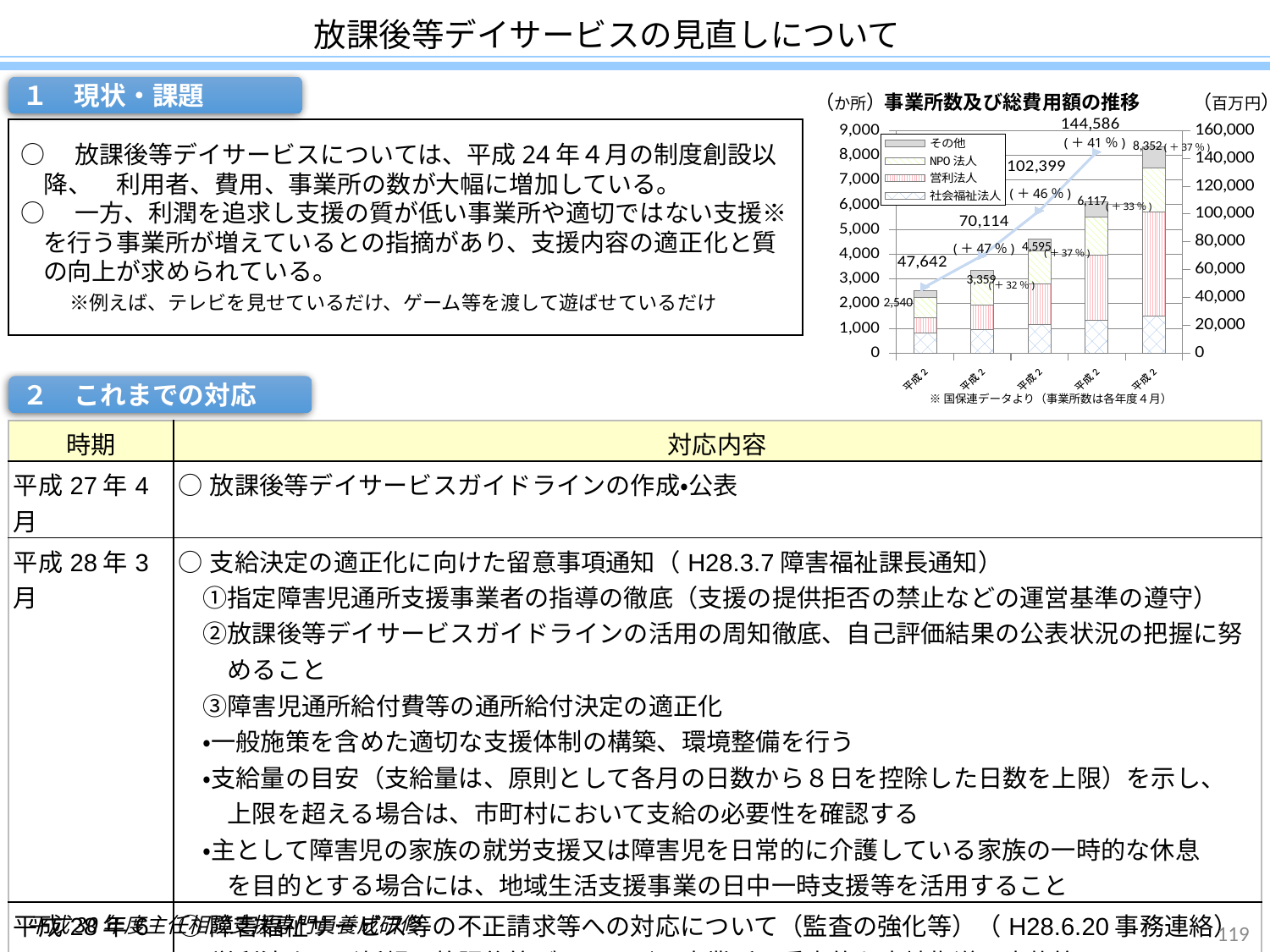
What is the lowest value labelled on the line in the chart? 47,642 Which bar has the highest total value? the rightmost (last) bar, 8,352 Do the bar totals rise or fall from left to right along the x axis? rise How many bars are plotted in the chart? 5 What is the difference between the total of the last bar (8,352) and the total of the first bar (2,540)? 5,812 How many series does the chart's legend list? 4 Which bar has the lowest total value? the leftmost (first) bar, 2,540 What is the title of the chart on the slide? 事業所数及び総費用額の推移 What is the total value labelled on the leftmost (first) bar? 2,540 What is the highest value labelled on the line in the chart? 144,586 What kind of chart is shown on the slide? combination bar and line chart (stacked bars with a line) What is the total value labelled on the rightmost (last) bar? 8,352